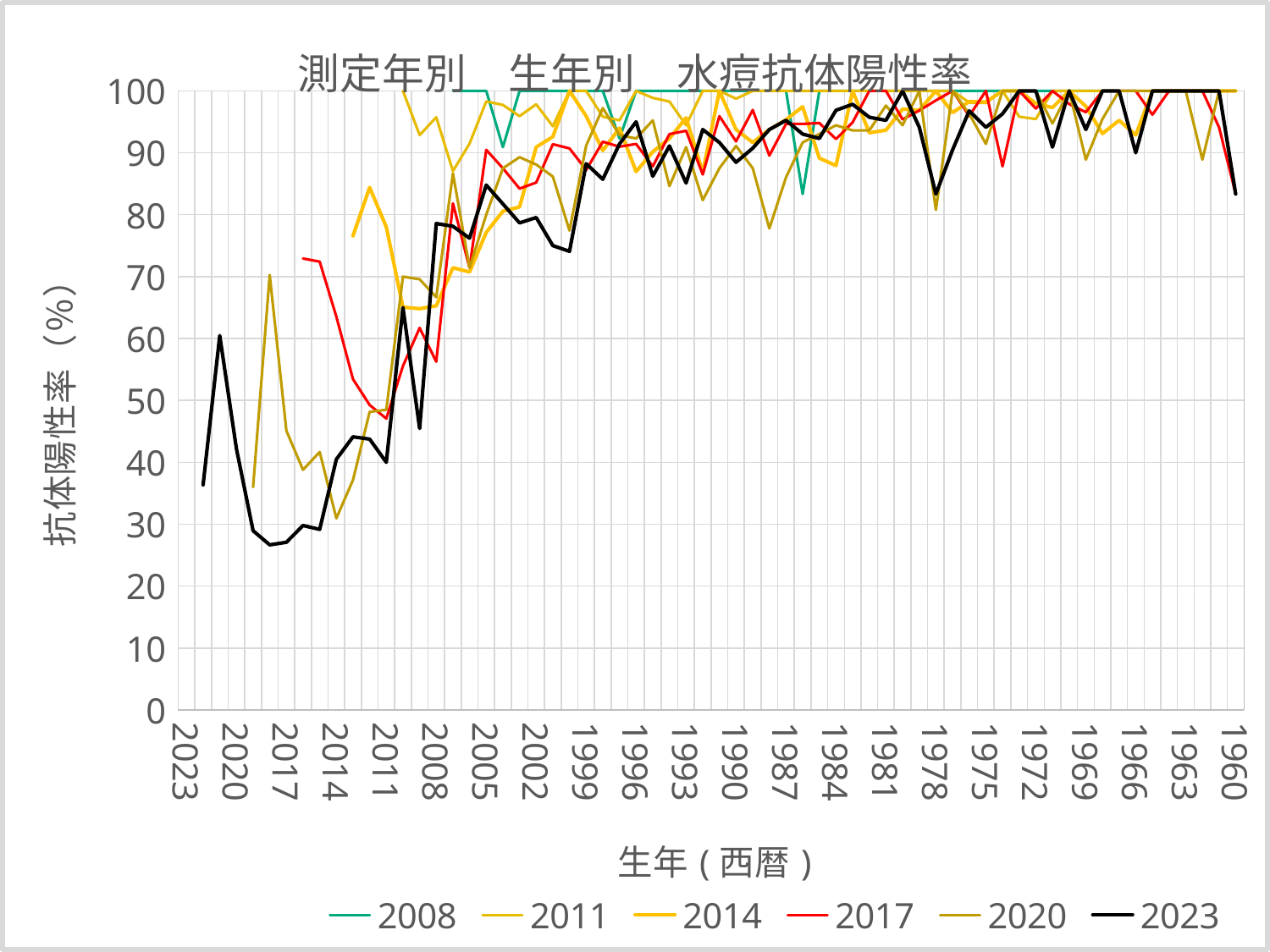
At birth year 2017, which series has the larger value, 2020 or 2023? 2020 Is the value of the 2017 series at birth year 2011 greater or less than 60? less What is the label of the y axis? 抗体陽性率（%） How many series does the legend list? 6 What is the title of the chart? 測定年別 生年別 水痘抗体陽性率 Is the value of the 2023 series at birth year 2017 greater or less than 40? less Moving along the x axis from birth year 2017 to birth year 1999, does the 2023 series generally rise or fall? rise Is the value of the 2023 series at birth year 1960 greater or less than 70? greater What kind of chart is shown on the slide? line chart What is the highest value shown on the y axis? 100